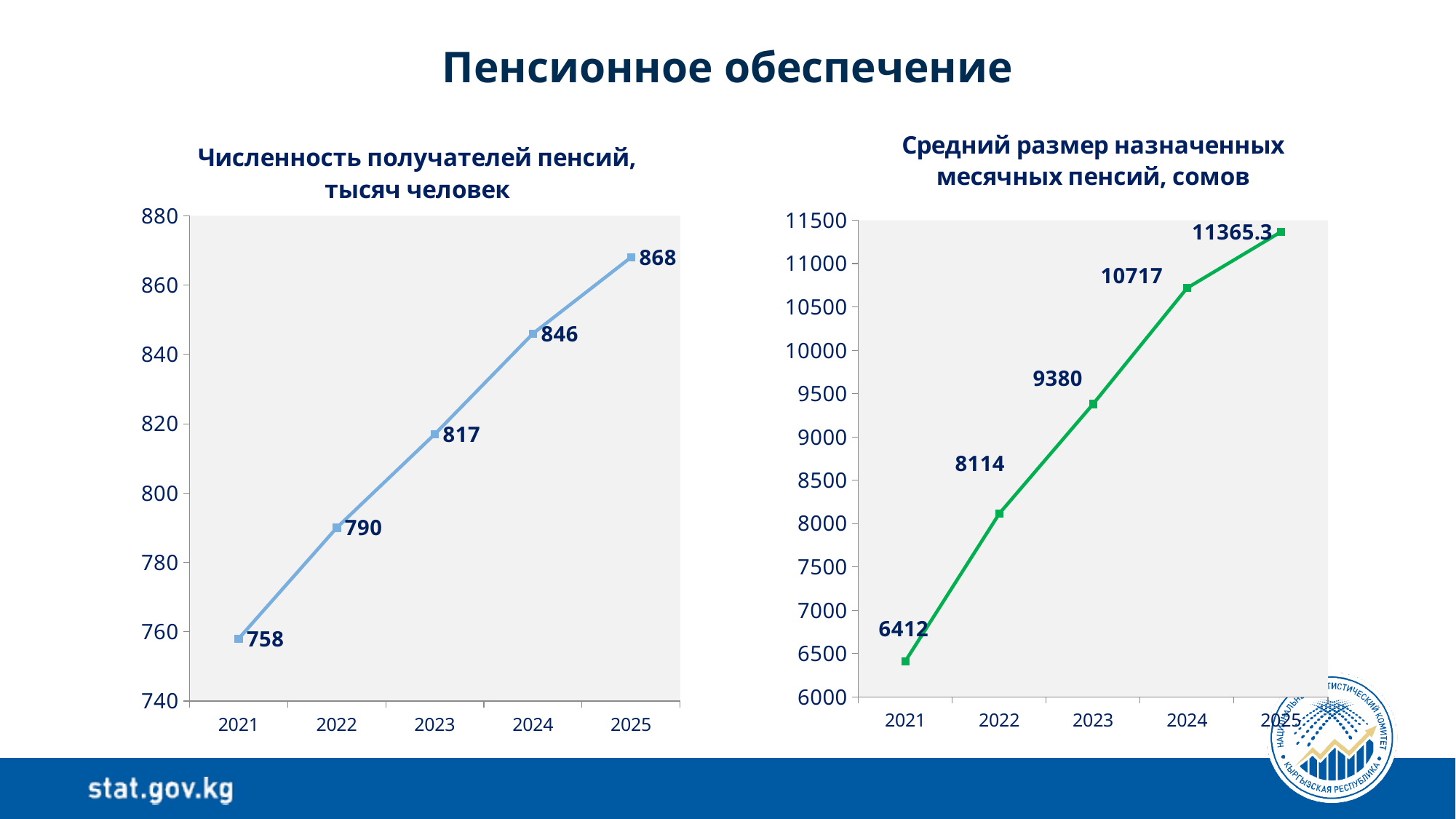
In the right chart (Средний размер назначенных месячных пенсий, сомов), what is the value for 2022? 8114 In the right chart (Средний размер назначенных месячных пенсий, сомов), what is the value for 2025? 11365.3 In the left chart (Численность получателей пенсий, тысяч человек), do the values rise or fall from 2021 to 2025? rise What kind of chart is the right chart (Средний размер назначенных месячных пенсий, сомов)? line chart In the left chart (Численность получателей пенсий, тысяч человек), what is the difference between the values for 2025 and 2021? 110 In the right chart (Средний размер назначенных месячных пенсий, сомов), which year has the lowest value? 2021 In the left chart (Численность получателей пенсий, тысяч человек), which year has the highest value? 2025 In the left chart (Численность получателей пенсий, тысяч человек), what is the value for 2021? 758 In the right chart (Средний размер назначенных месячных пенсий, сомов), what is the difference between the values for 2024 and 2023? 1337 In the right chart (Средний размер назначенных месячных пенсий, сомов), is the value for 2023 greater or less than 9000? greater How many data points are plotted in the left chart (Численность получателей пенсий, тысяч человек)? 5 In the left chart (Численность получателей пенсий, тысяч человек), what is the value for 2023? 817